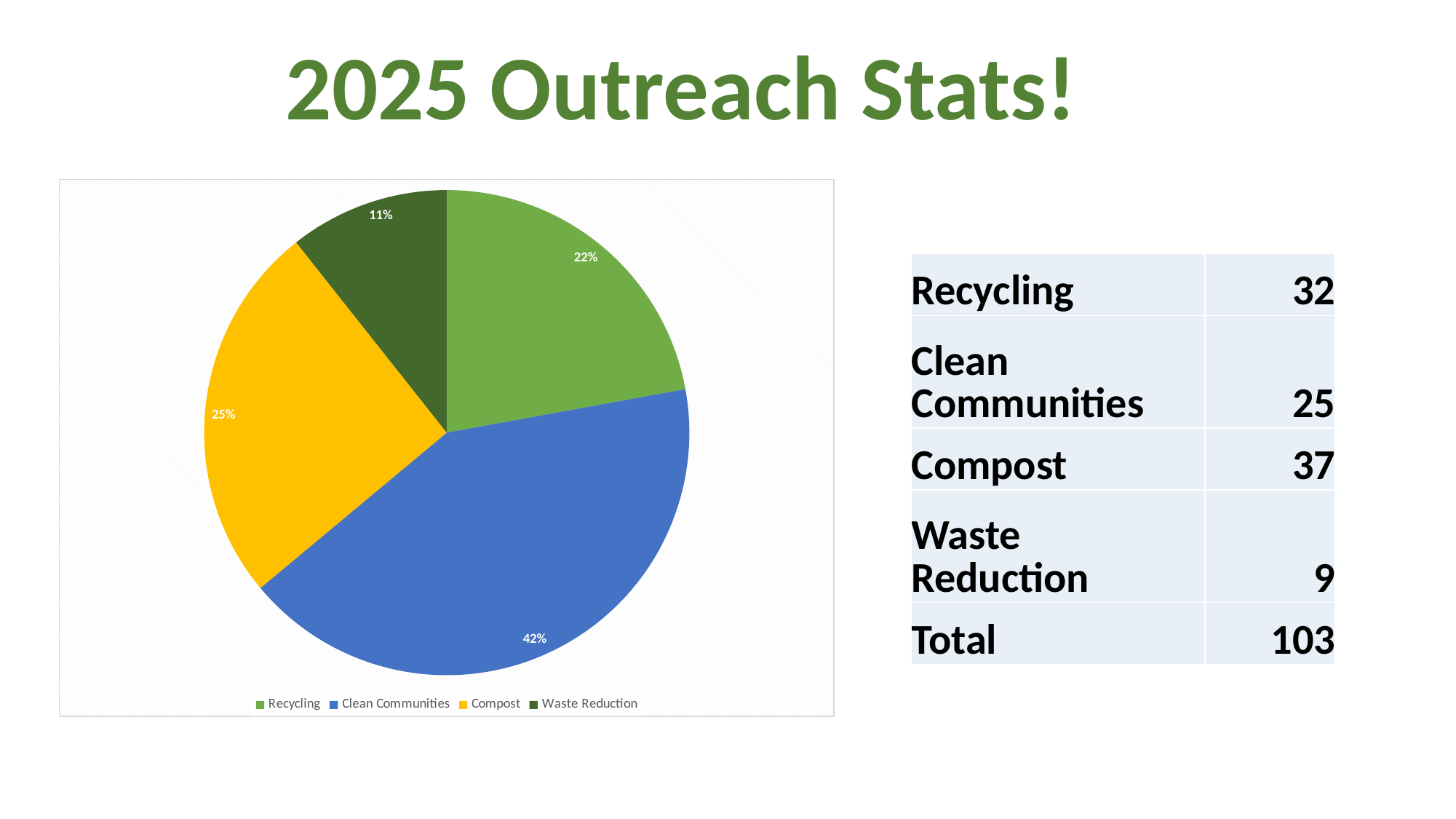
What percentage of the pie chart does Recycling represent? 22% What percentage of the pie chart does Waste Reduction represent? 11% What type of chart is shown on the slide? Pie chart How many entries does the pie chart's legend list? 4 What percentage of the pie chart does Clean Communities represent? 42% Which category has the smallest slice in the pie chart? Waste Reduction In the pie chart, which slice is larger: Compost or Recycling? Compost What percentage of the pie chart does Compost represent? 25% What colour is the Compost slice in the pie chart? Yellow What is the difference in percentage points between the Clean Communities slice and the Waste Reduction slice in the pie chart? 31 How many slices does the pie chart have? 4 Which category has the largest slice in the pie chart? Clean Communities